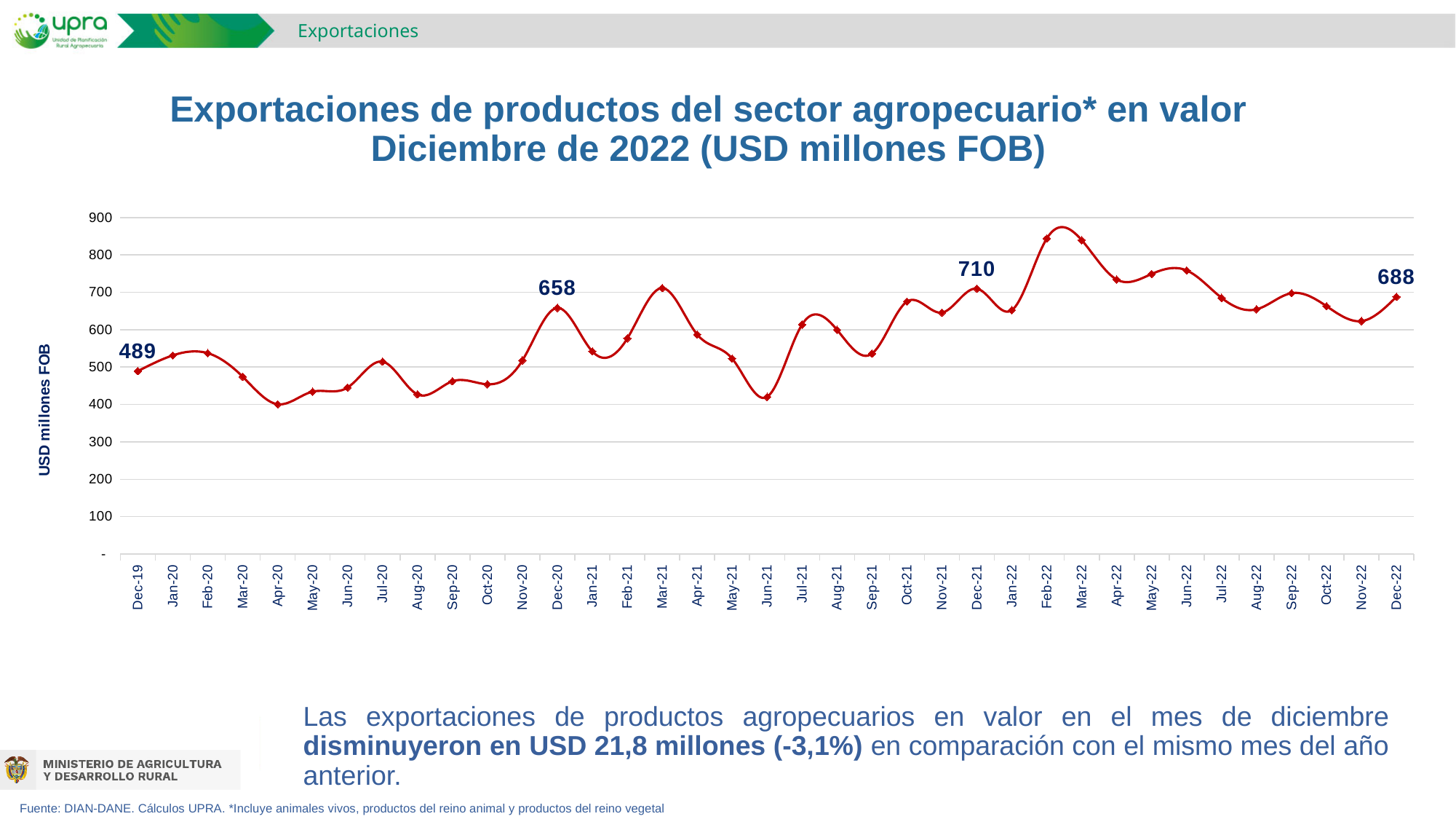
What is the difference between the values for Dec-21 and Dec-22? 22 Which month has the lowest value on the chart? Apr-20 What is the value for Dec-22? 688 Is the value for Apr-20 greater or less than 500? less What is the value for Dec-21? 710 What is the difference between the values for Dec-20 and Dec-19? 169 What is the value for Dec-20? 658 What is the title of the vertical axis? USD millones FOB What is the value for Dec-19? 489 What kind of chart is shown on the slide? line chart Is the value for Feb-22 greater or less than 800? greater Which is larger, the value for Dec-21 or the value for Dec-22? Dec-21